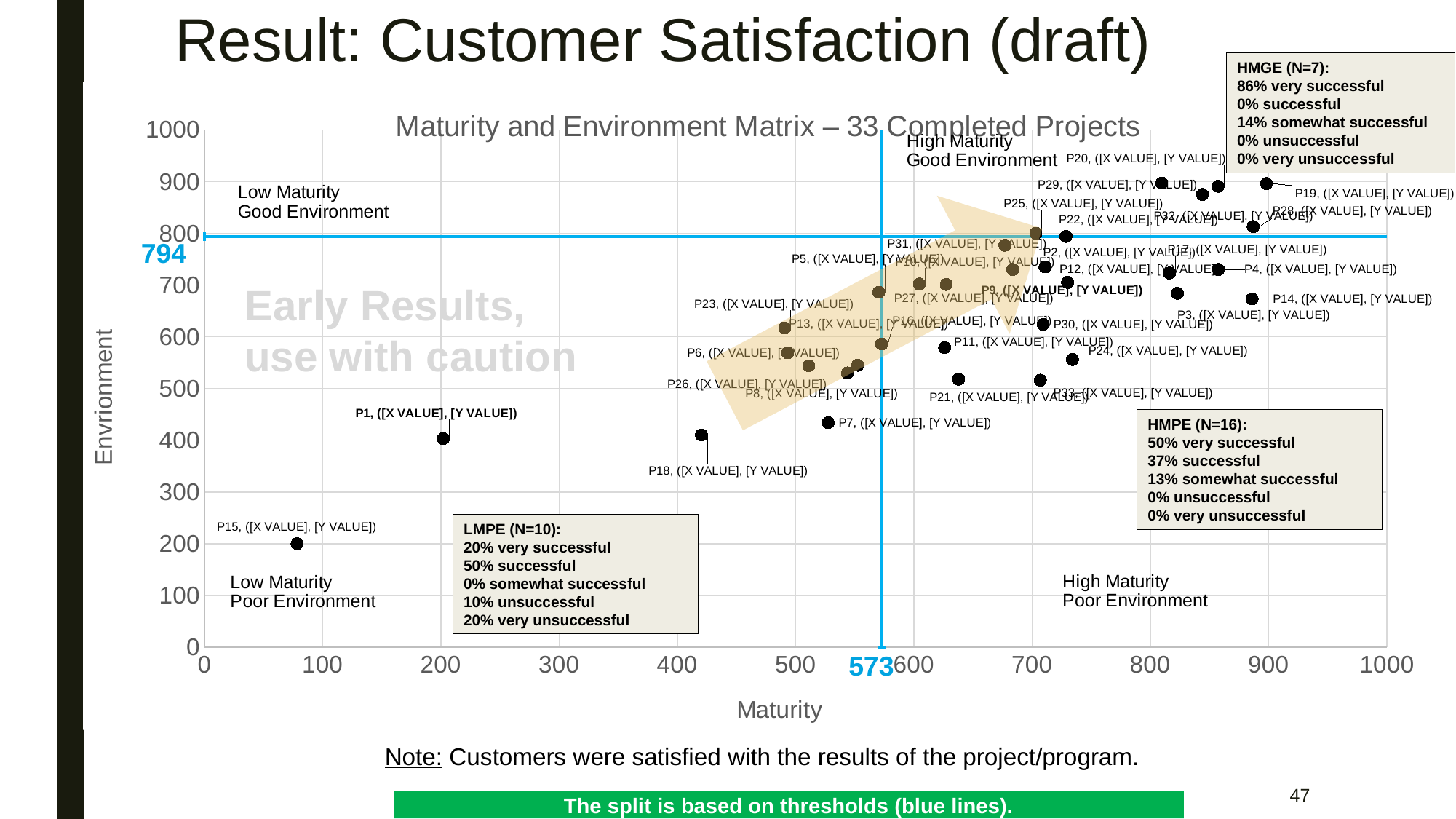
What Environment value does the horizontal blue threshold line mark? 794 Which project has the lowest Environment value? P15 Is the Environment value for P19 greater or less than 800? greater What kind of chart is shown on the slide? scatter chart Is the Maturity value for P15 greater or less than 100? less What is the label of the horizontal axis of the chart? Maturity Is the Maturity value for P1 greater or less than 300? less What is the title of the chart? Maturity and Environment Matrix – 33 Completed Projects How many completed projects does the chart title say are plotted? 33 Which project has the higher Environment value, P1 or P15? P1 What Maturity value does the vertical blue threshold line mark? 573